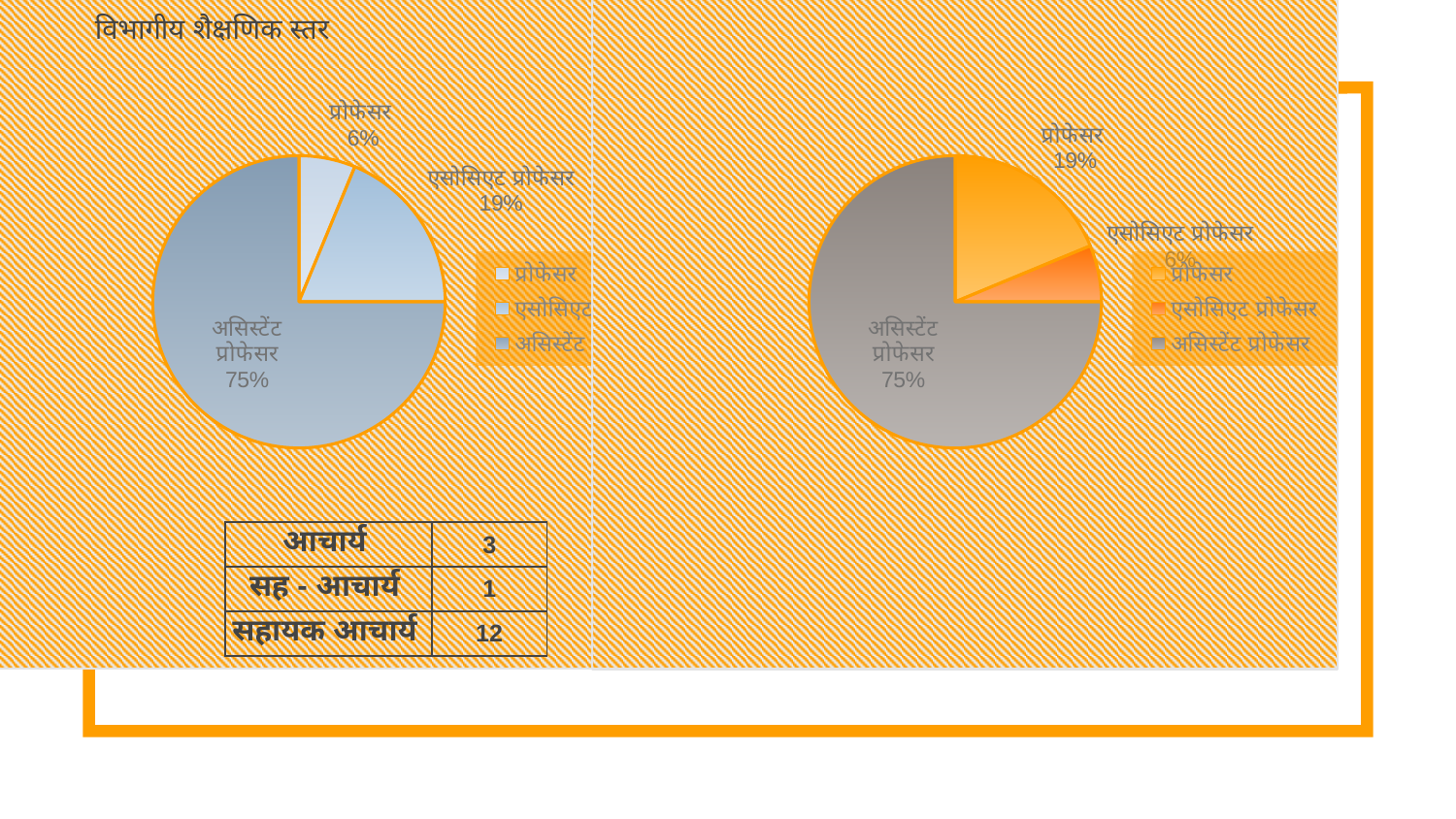
On the left pie chart, what share is labelled for एसोसिएट प्रोफेसर? 19% On the left pie chart, what is the difference in percentage points between असिस्टेंट प्रोफेसर and एसोसिएट प्रोफेसर? 56 On the right pie chart, what share is labelled for एसोसिएट प्रोफेसर? 6% On the right pie chart, which category has the largest slice? असिस्टेंट प्रोफेसर On the left pie chart, which is larger: the slice for एसोसिएट प्रोफेसर or the slice for प्रोफेसर? एसोसिएट प्रोफेसर How many slices does the right pie chart have? 3 On the left pie chart, what share is labelled for असिस्टेंट प्रोफेसर? 75% What type of chart is shown on the left side of the slide? Pie chart On the right pie chart, which category has the smallest slice? एसोसिएट प्रोफेसर On the left pie chart, which category has the smallest slice? प्रोफेसर